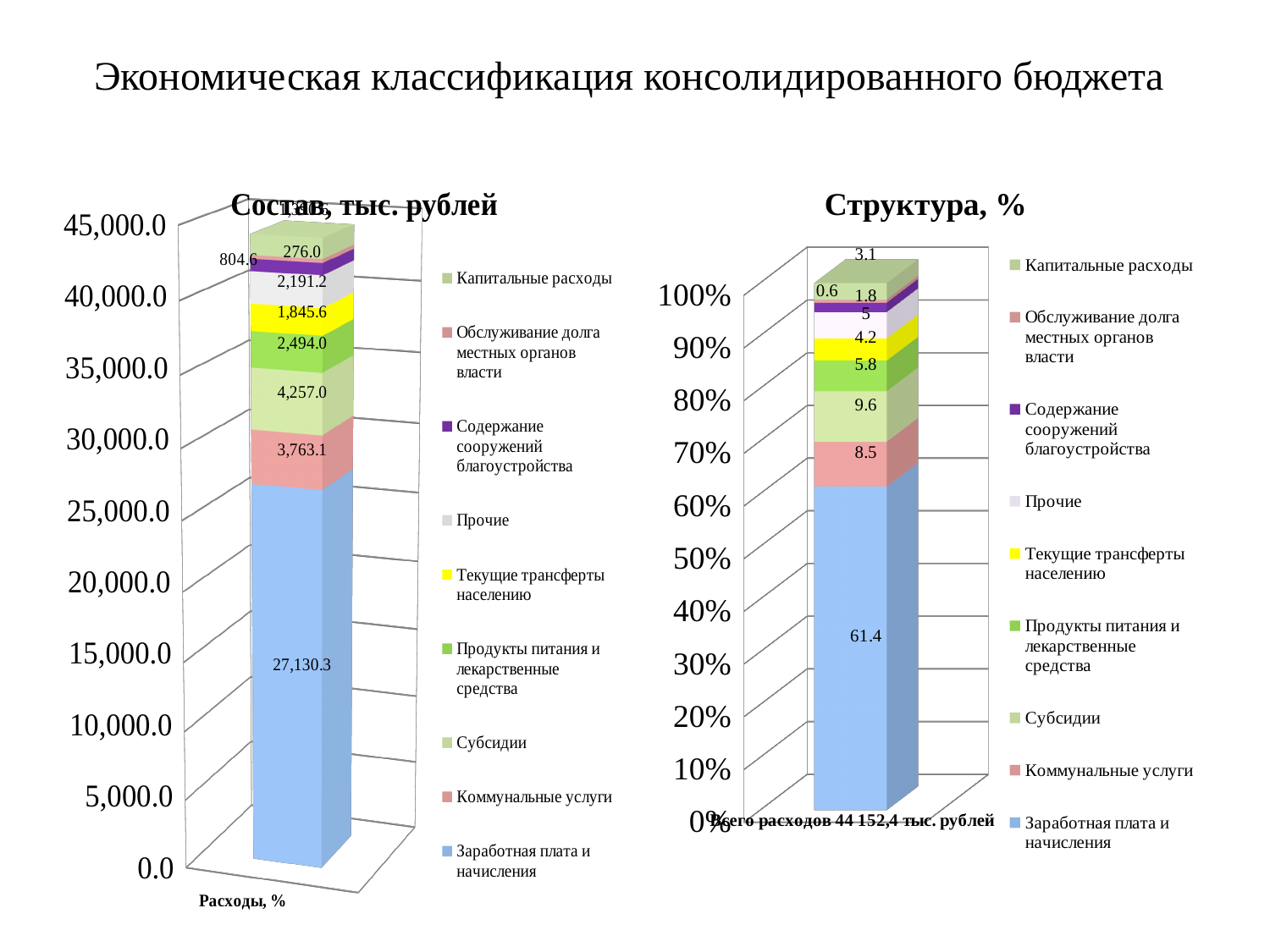
In the right chart "Структура, %", what is the share for Заработная плата и начисления? 61.4 In the left chart "Состав, тыс. рублей", what is the value for Субсидии? 4,257.0 In the left chart "Состав, тыс. рублей", what is the value for Коммунальные услуги? 3,763.1 What type of chart is shown on the left under the title "Состав, тыс. рублей"? stacked bar chart In the right chart "Структура, %", which is larger: Субсидии or Коммунальные услуги? Субсидии How many series does the legend of the right chart "Структура, %" list? 9 In the right chart "Структура, %", what is the share for Капитальные расходы? 3.1 In the left chart "Состав, тыс. рублей", what is the difference between Субсидии and Коммунальные услуги? 493.9 In the left chart "Состав, тыс. рублей", which category has the largest segment? Заработная плата и начисления According to the text under the right chart, what is the total of all expenditures (Всего расходов)? 44 152,4 тыс. рублей In the left chart "Состав, тыс. рублей", what is the value for Заработная плата и начисления? 27,130.3 In the left chart "Состав, тыс. рублей", what is the value for Текущие трансферты населению? 1,845.6